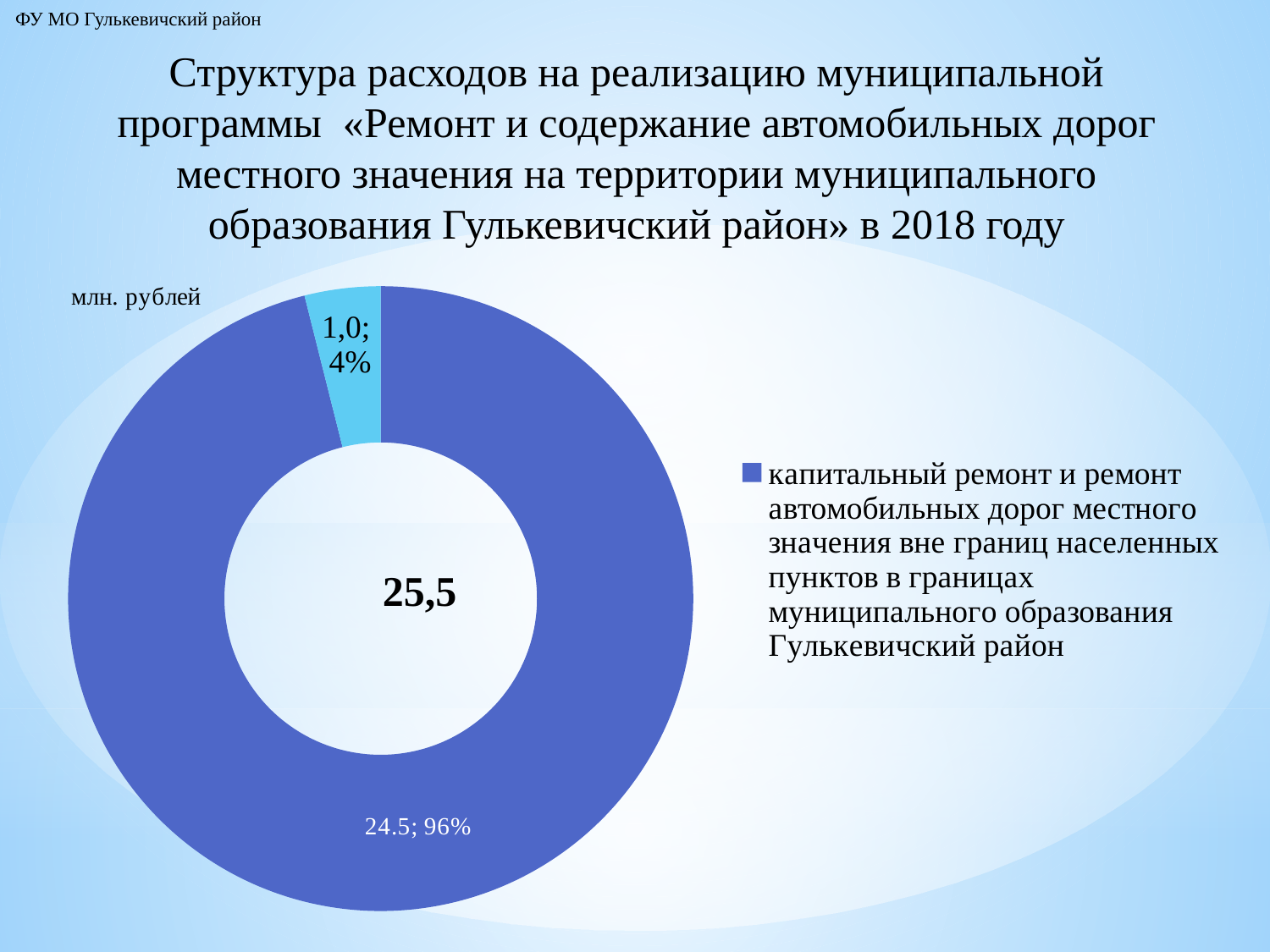
What kind of chart is shown on the slide? doughnut (pie) chart Which is larger: the slice labelled 24.5 or the slice labelled 1,0? the slice labelled 24.5 In what units are the chart values given? млн. рублей What is the value of the small light-blue slice? 1,0 What is the value for «капитальный ремонт и ремонт автомобильных дорог местного значения вне границ населенных пунктов в границах муниципального образования Гулькевичский район»? 24.5 Which slice is the largest? капитальный ремонт и ремонт автомобильных дорог местного значения вне границ населенных пунктов в границах муниципального образования Гулькевичский район What share of the chart does the small light-blue slice represent? 4% How many entries does the legend list? 1 What total value is printed in the centre of the doughnut? 25,5 How many slices does the chart have? 2 Which year does the chart title refer to? 2018 What share of the chart does the slice for капитальный ремонт и ремонт автомобильных дорог местного значения represent? 96%